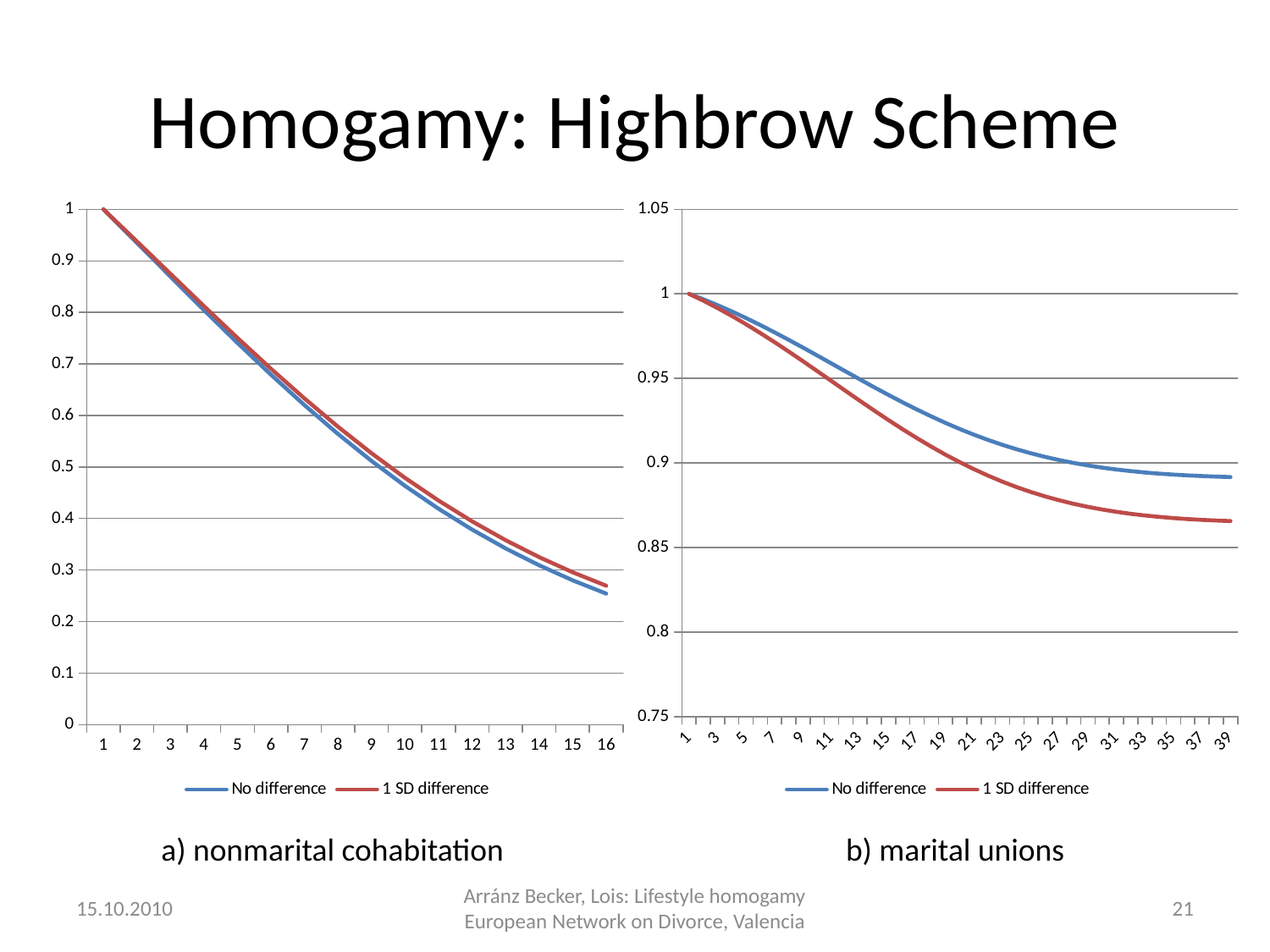
In the right chart (b) marital unions), what is the value of the 1 SD difference series at x = 1? 1 In the left chart (a) nonmarital cohabitation), at x = 16, which series has the higher value: No difference or 1 SD difference? 1 SD difference In the left chart (a) nonmarital cohabitation), is the value of the No difference series at x = 16 greater or less than 0.3? less In the left chart (a) nonmarital cohabitation), what is the value of the No difference series at x = 1? 1 How many series does the legend of the right chart, b) marital unions, list? 2 In the left chart (a) nonmarital cohabitation), how many points are labelled on the x axis? 16 In the right chart (b) marital unions), at x = 39, which series has the higher value: No difference or 1 SD difference? No difference What colour is the 1 SD difference series in the legend of the left chart? red In the right chart (b) marital unions), is the value of the 1 SD difference series at x = 39 greater or less than 0.85? greater In the right chart (b) marital unions), do the values of the 1 SD difference series rise or fall along the x axis? fall In the left chart (a) nonmarital cohabitation), do the values rise or fall along the x axis? fall What kind of chart is the left chart, labelled a) nonmarital cohabitation? line chart